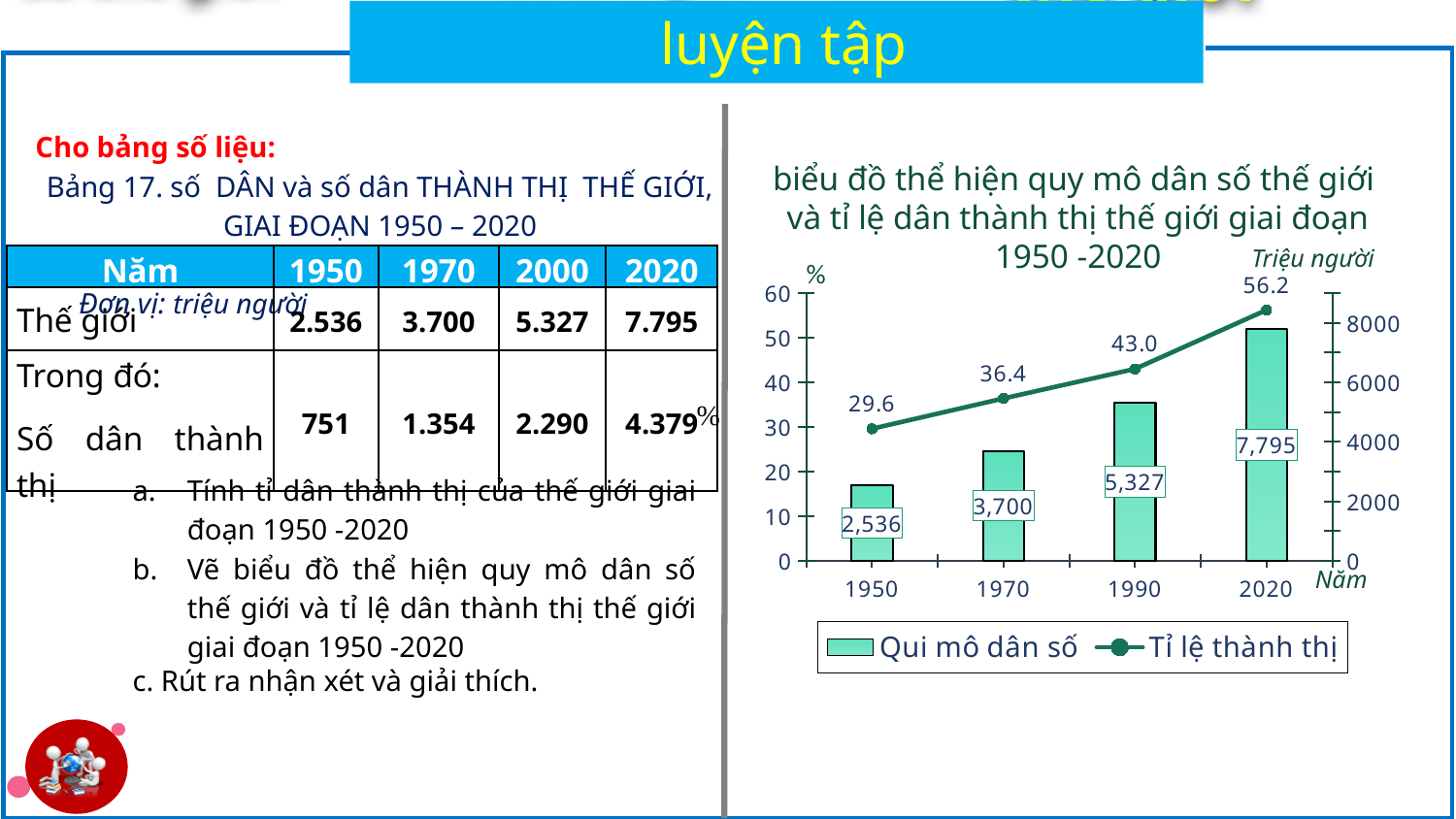
How many years are shown on the x axis of the chart? 4 Does the 'Tỉ lệ thành thị' line rise or fall from 1950 to 2020? rise What is the value of the 'Tỉ lệ thành thị' line for 2020? 56.2 What is the difference between the 'Qui mô dân số' values for 2020 and 1950? 5,259 Which is larger: the 'Qui mô dân số' bar for 1970 or for 1990? 1990 What is the value of the 'Qui mô dân số' bar for 1950? 2,536 How many series does the chart legend list? 2 What is the value of the 'Tỉ lệ thành thị' line for 1970? 36.4 What is the difference between the 'Tỉ lệ thành thị' values for 1990 and 1970? 6.6 Which year has the lowest 'Tỉ lệ thành thị' value? 1950 Which year has the highest 'Qui mô dân số' bar? 2020 What is the value of the 'Qui mô dân số' bar for 1990? 5,327